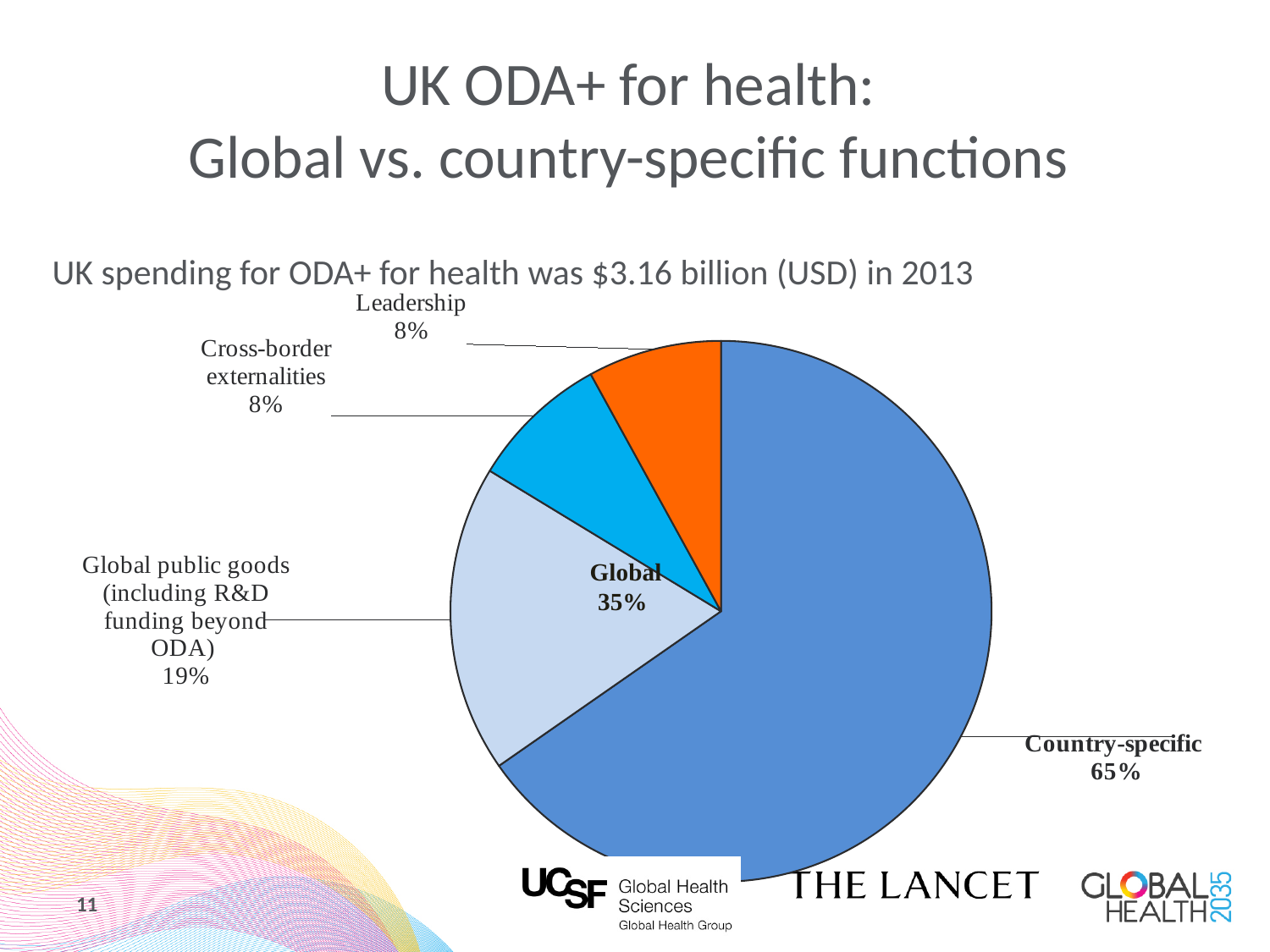
What percentage is shown for Leadership? 8% What share of UK ODA+ for health goes to country-specific functions? 65% What kind of chart is shown on the slide? pie chart What is the difference in percentage points between Country-specific and Global public goods? 46 How many individual slices does the pie chart have? 4 What is the combined share of Cross-border externalities and Leadership? 16% What percentage is labelled for Global functions as a whole? 35% Which is larger, the Global public goods slice or the Cross-border externalities slice? Global public goods What share of the pie is Global public goods (including R&D funding beyond ODA)? 19% Which slice of the pie is the largest? Country-specific What percentage is shown for Cross-border externalities? 8% According to the slide, how much did the UK spend on ODA+ for health in 2013? $3.16 billion (USD)